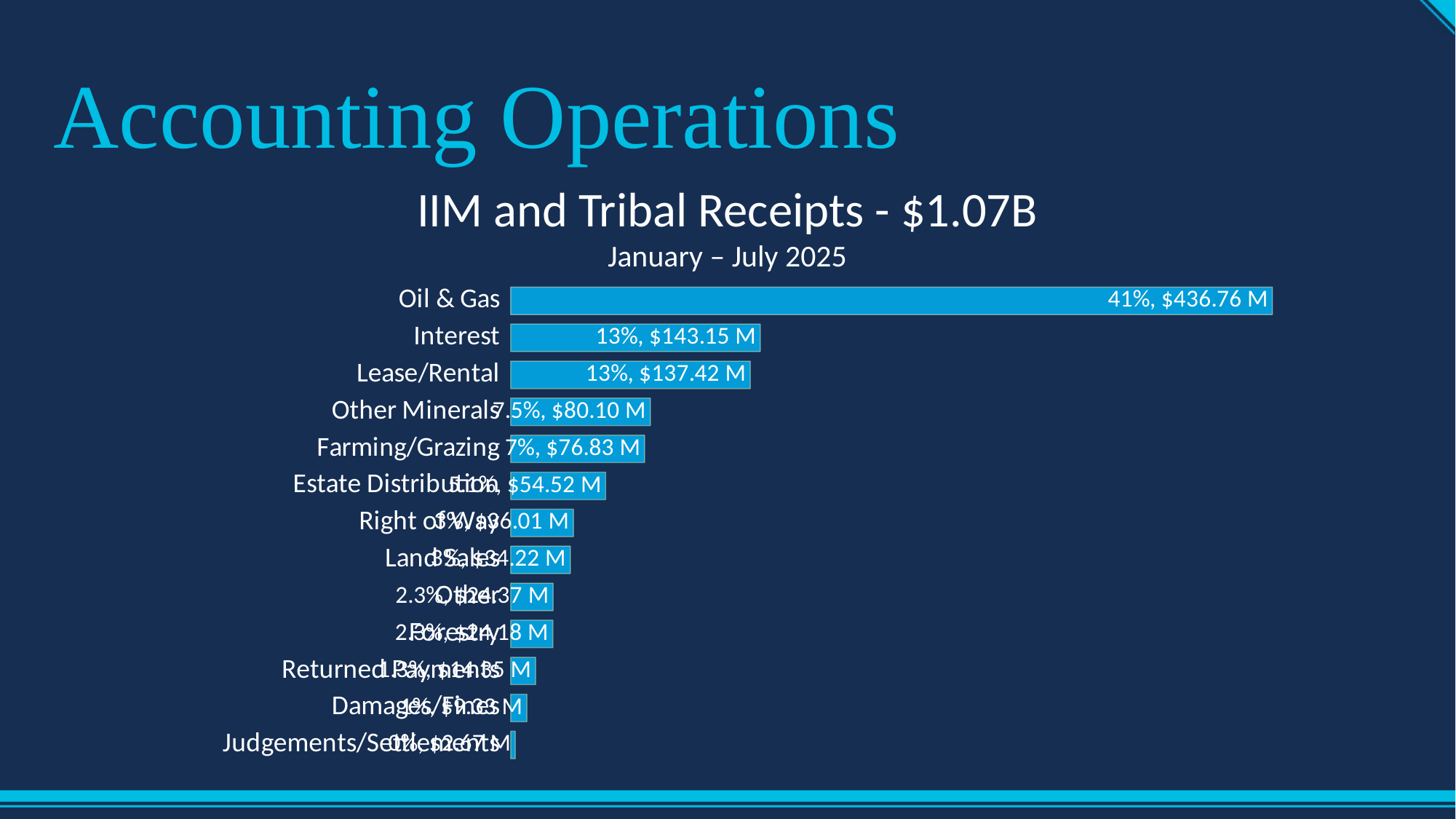
What is the value for Other Minerals? 7.5%, $80.10 M Which is larger, Other Minerals or Farming/Grazing? Other Minerals What is the difference in dollar value between Interest and Lease/Rental? $5.73 M What is the value for Interest? 13%, $143.15 M What is the title of the chart? IIM and Tribal Receipts - $1.07B How many categories are shown in the chart? 13 Which category has the lowest value? Judgements/Settlements What is the value for Farming/Grazing? 7%, $76.83 M What is the value for Oil & Gas? 41%, $436.76 M What kind of chart is this? Bar chart What is the value for Lease/Rental? 13%, $137.42 M Which category has the highest value? Oil & Gas